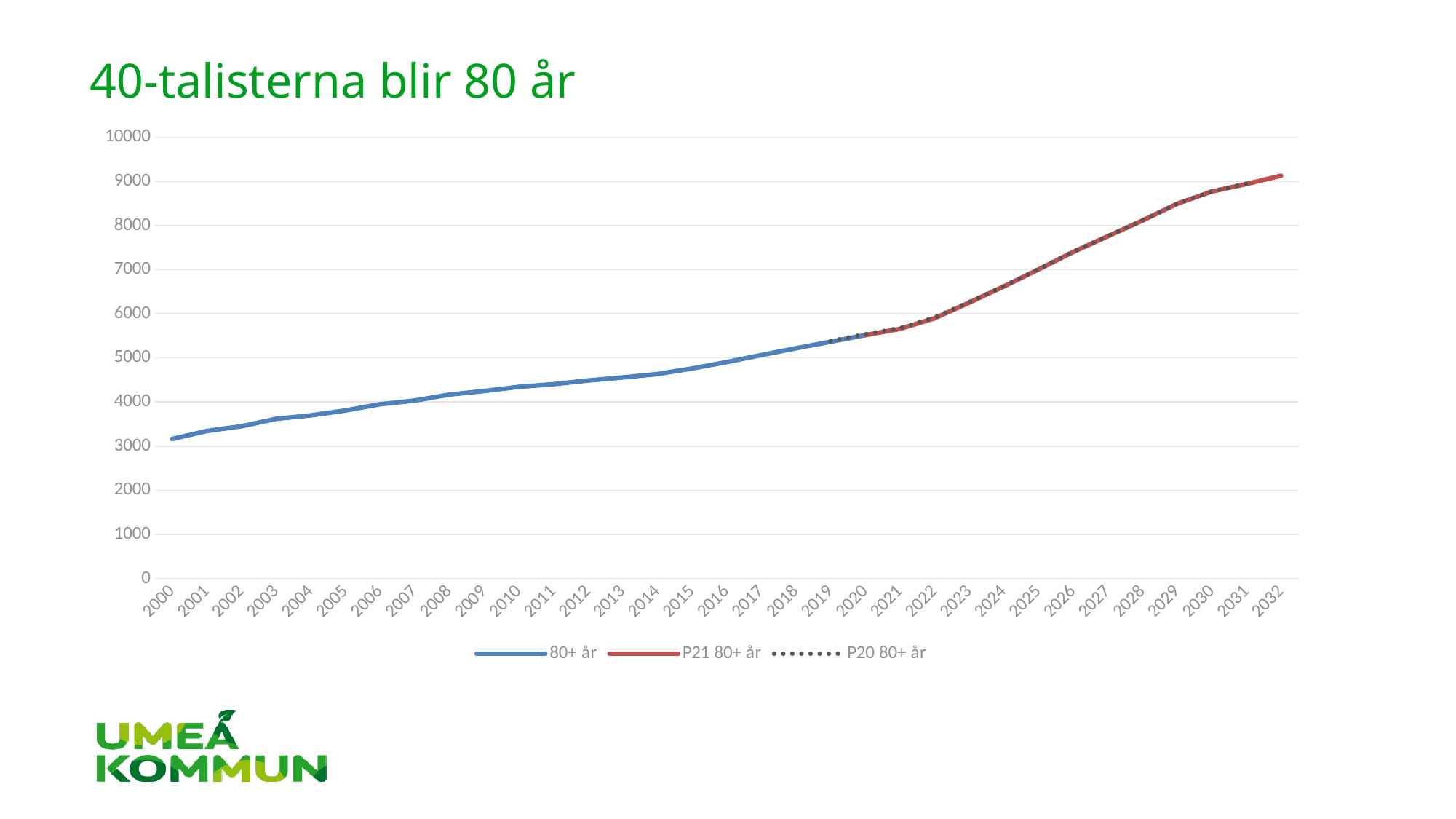
Is the value for 2010 greater or less than 4000? greater Which year has the highest value on the chart? 2032 Which year has the lowest value on the chart? 2000 What kind of chart is shown on the slide? line chart What is the title of the chart on the slide? 40-talisterna blir 80 år Do the values rise or fall from 2000 to 2032? rise How many series does the legend list? 3 Which series is drawn as a dotted line in the legend? P20 80+ år Which is larger, the value for 2020 or the value for 2005? 2020 How many years are labelled along the x axis? 33 Is the value for 2000 greater or less than 4000? less Is the value for 2032 greater or less than 8000? greater